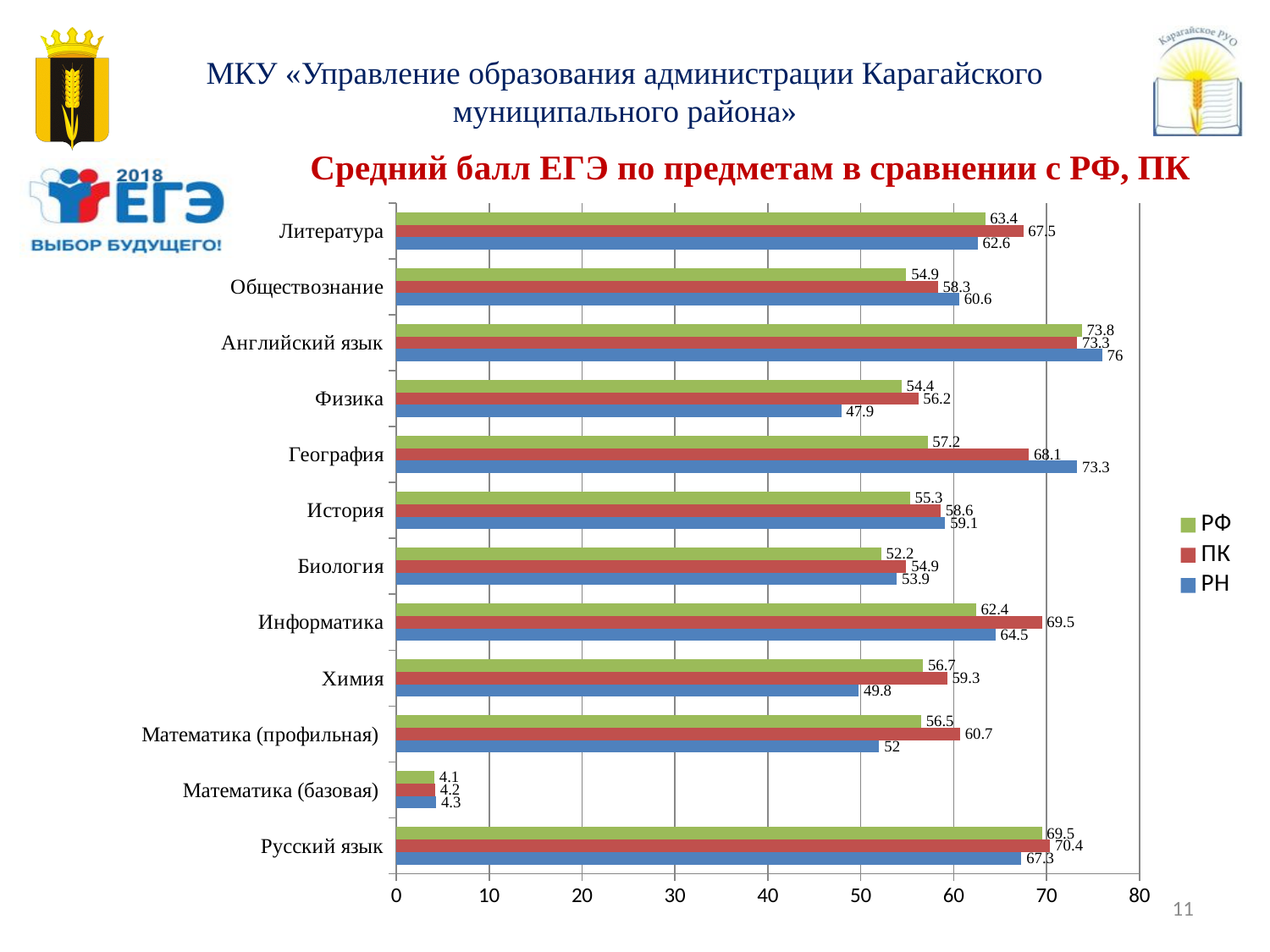
What is the РН value for Английский язык? 76 What is the title of the chart? Средний балл ЕГЭ по предметам в сравнении с РФ, ПК Which subject has the highest РН value? Английский язык What is the РФ value for Русский язык? 69.5 What is the ПК value for География? 68.1 What kind of chart is shown on the slide? Bar chart How many subjects are shown on the chart? 12 Which subject has the lowest ПК value? Математика (базовая) For Химия, which is larger: the ПК value or the РН value? ПК What is the РН value for Физика? 47.9 What is the difference between the РН and РФ values for География? 16.1 How many series does the legend list? 3